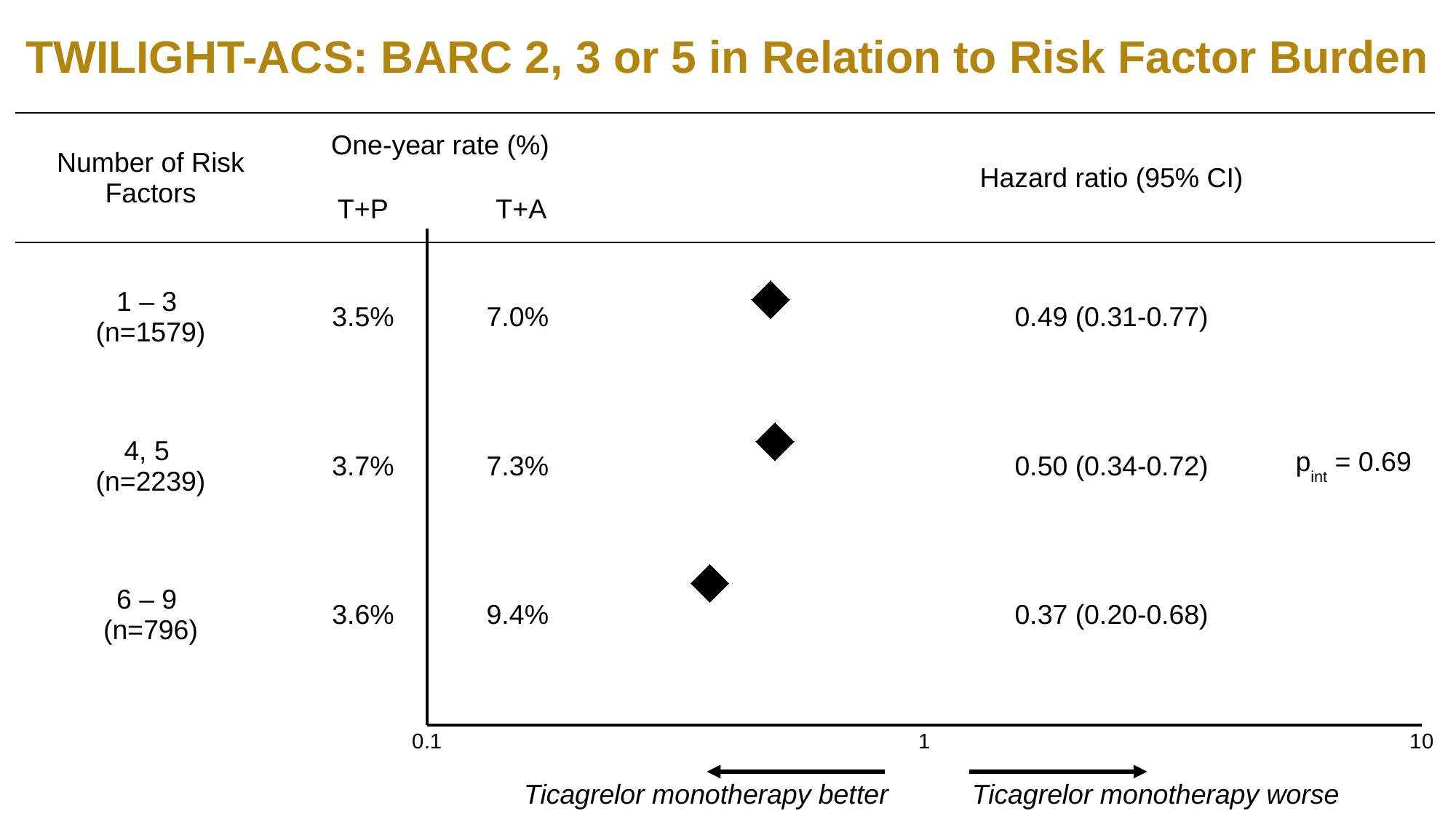
What is the one-year T+P rate for patients with 6 – 9 risk factors? 3.6% What is the one-year T+A rate for patients with 4, 5 risk factors? 7.3% How many risk factor groups are plotted on the chart? 3 Which risk factor group has the lowest hazard ratio? 6 – 9 Which risk factor group has the highest one-year T+A rate? 6 – 9 Is the hazard ratio for the 4, 5 risk factor group greater or less than 1? less What is the hazard ratio (95% CI) for patients with 6 – 9 risk factors? 0.37 (0.20-0.68) What is the number of patients in the 4, 5 risk factor group? 2239 What is the p-value for interaction shown on the slide? 0.69 What is the hazard ratio (95% CI) for patients with 1 – 3 risk factors? 0.49 (0.31-0.77) What is the difference between the T+A and T+P one-year rates for the 1 – 3 risk factor group? 3.5% Which is larger, the hazard ratio for the 4, 5 group or the 6 – 9 group? 4, 5